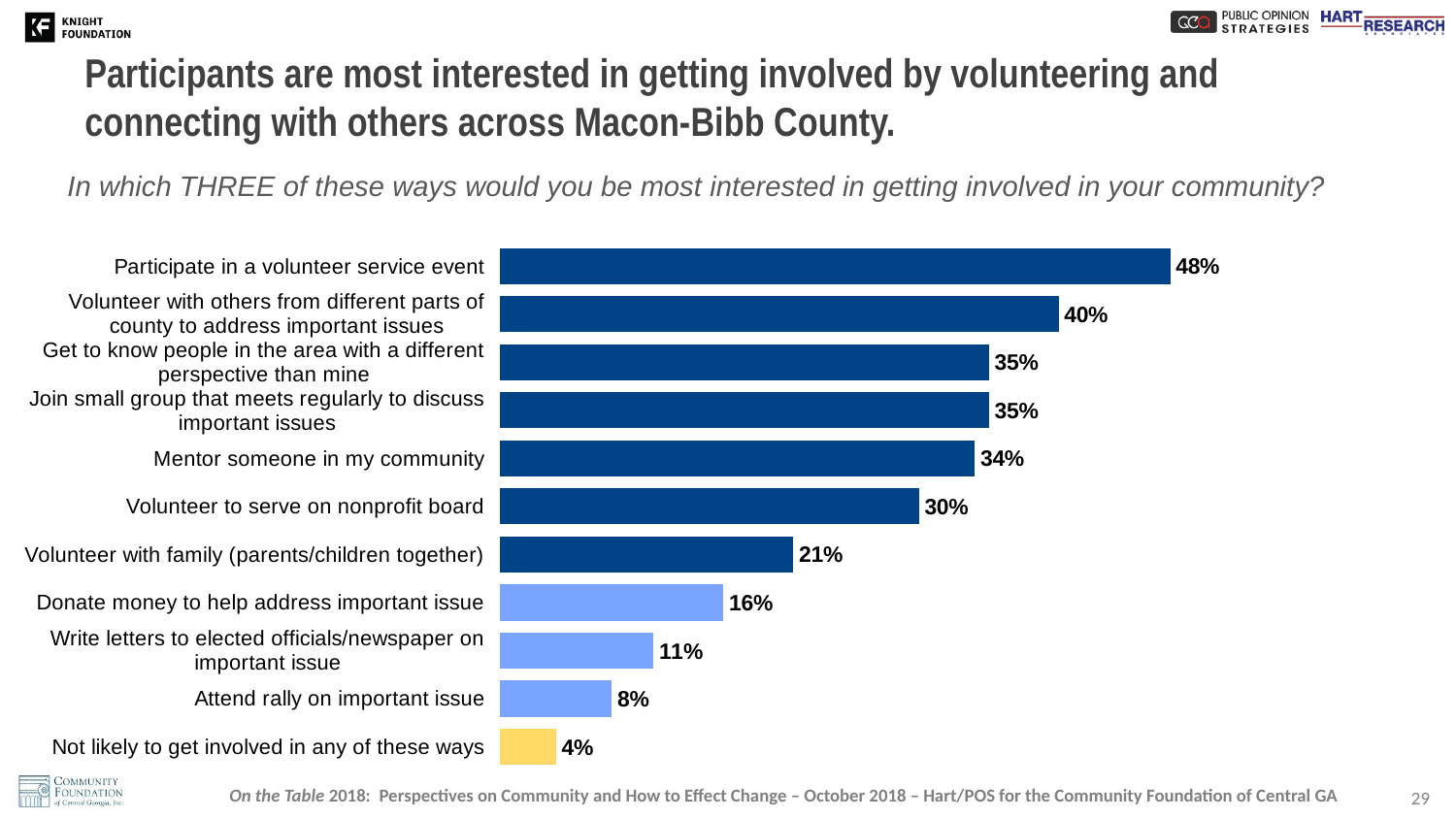
What is the difference between 'Volunteer to serve on nonprofit board' and 'Attend rally on important issue'? 22% What is the value for 'Mentor someone in my community'? 34% What is the difference between 'Participate in a volunteer service event' and 'Volunteer with others from different parts of county to address important issues'? 8% What percentage would donate money to help address an important issue? 16% What percentage of participants are interested in participating in a volunteer service event? 48% How many categories are shown on the chart? 11 Which is larger: 'Volunteer with family (parents/children together)' or 'Write letters to elected officials/newspaper on important issue'? Volunteer with family (parents/children together) Which category has the lowest value on the chart? Not likely to get involved in any of these ways Do the values rise or fall going from the top bar to the bottom bar? Fall What colour is the bar for 'Not likely to get involved in any of these ways'? Yellow Which category has the highest value on the chart? Participate in a volunteer service event What kind of chart is shown on the slide? Bar chart